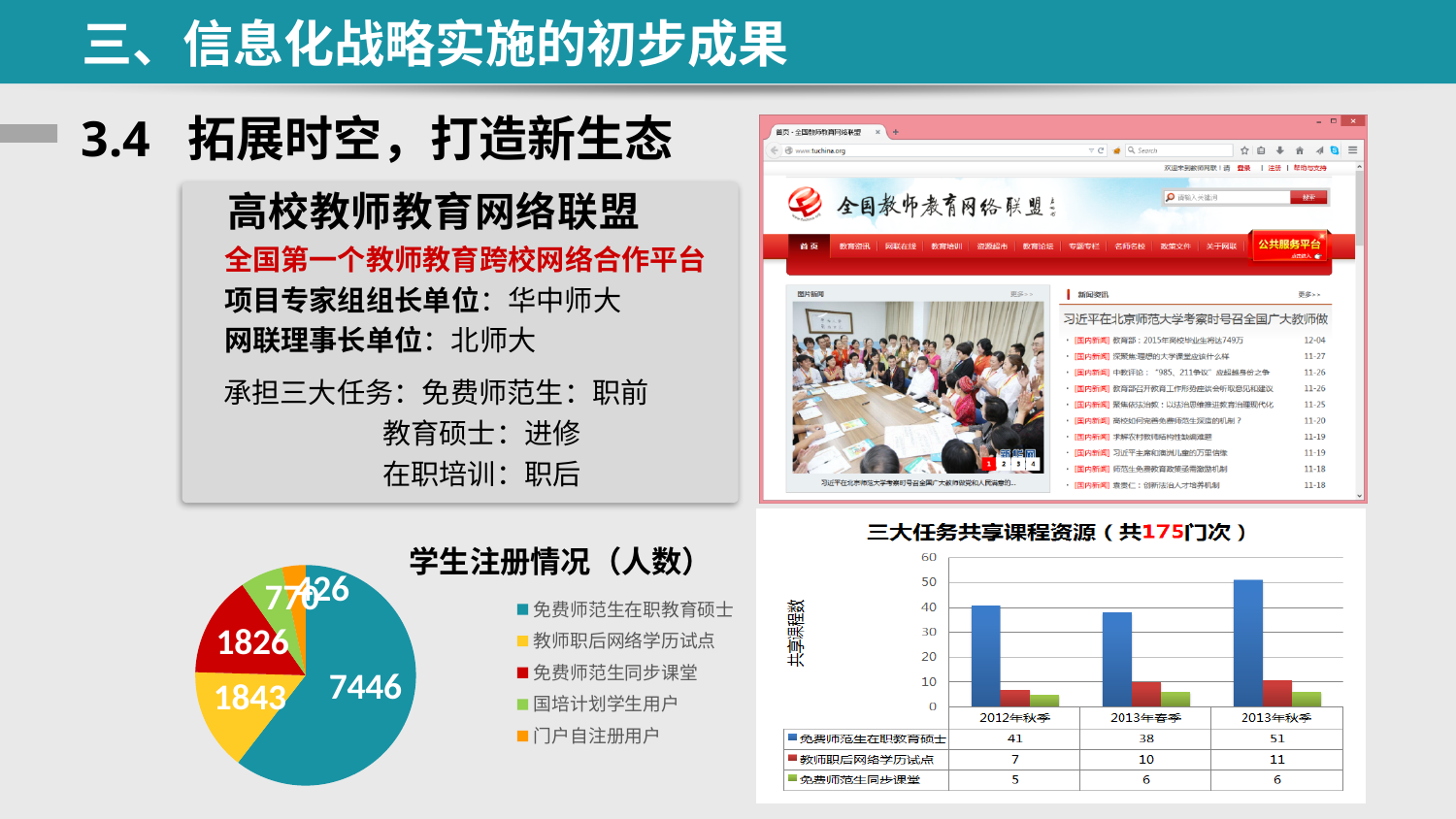
In the bar chart titled 三大任务共享课程资源, does the value for 教师职后网络学历试点 rise or fall from 2012年秋季 to 2013年秋季? rise In the pie chart titled 学生注册情况（人数）, what is the value for 免费师范生在职教育硕士? 7446 In the pie chart titled 学生注册情况（人数）, what is the difference between the values for 教师职后网络学历试点 and 免费师范生同步课堂? 17 In the bar chart titled 三大任务共享课程资源, what is the difference between the 免费师范生在职教育硕士 values for 2013年秋季 and 2013年春季? 13 In the bar chart titled 三大任务共享课程资源, what is the value for 免费师范生同步课堂 in 2012年秋季? 5 What kind of chart is the chart titled 学生注册情况（人数）? pie chart In the pie chart titled 学生注册情况（人数）, which category has the smallest value? 门户自注册用户 In the bar chart titled 三大任务共享课程资源, which period has the highest value for 免费师范生在职教育硕士? 2013年秋季 In the bar chart titled 三大任务共享课程资源, what is the value for 免费师范生在职教育硕士 in 2013年秋季? 51 In the bar chart titled 三大任务共享课程资源, how many series does the legend list? 3 In the bar chart titled 三大任务共享课程资源, how many periods are shown on the x axis? 3 In the bar chart titled 三大任务共享课程资源, what is the value for 教师职后网络学历试点 in 2013年春季? 10